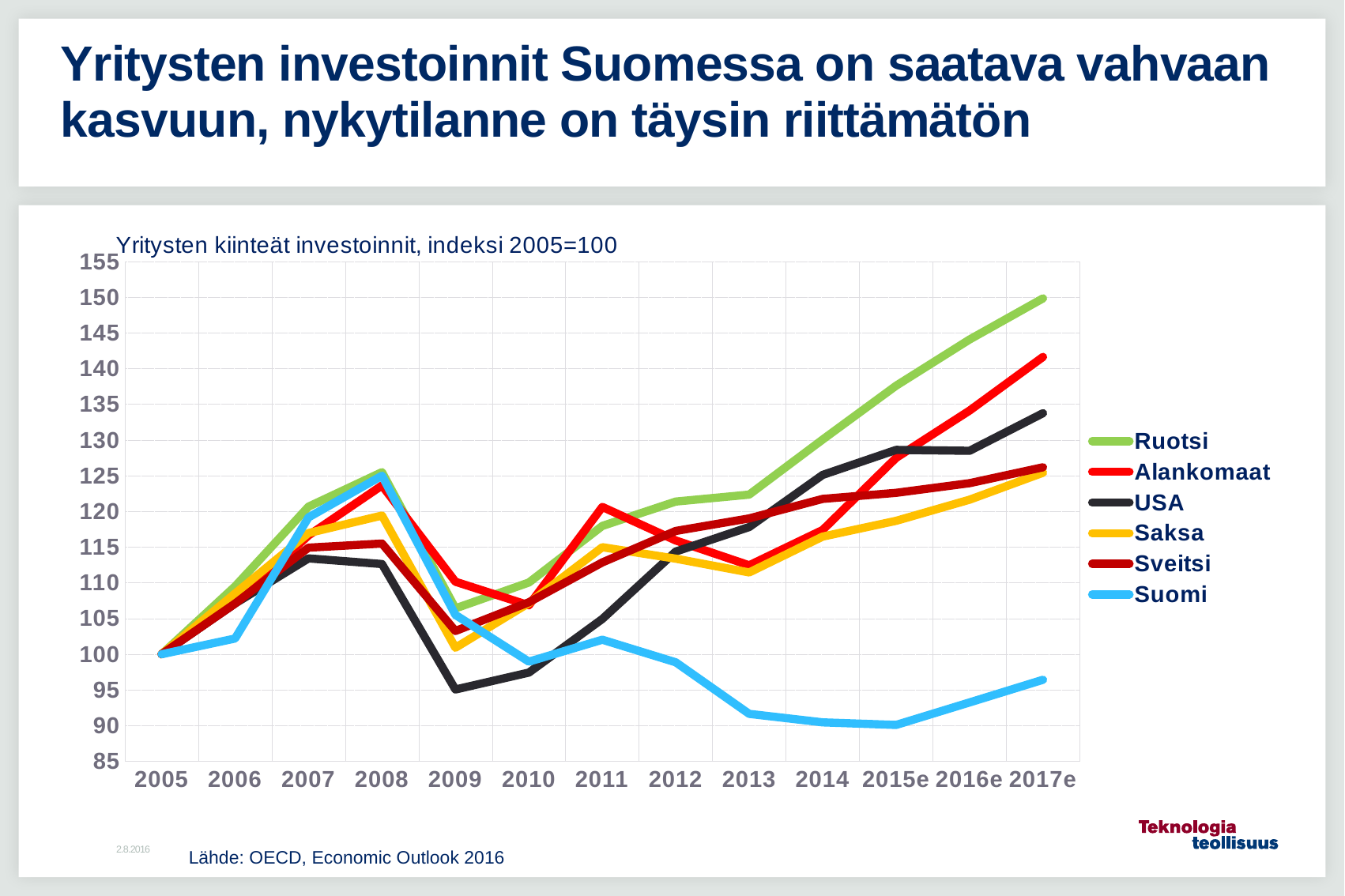
Is the value for USA in 2009 greater or less than 100? less Which country has the lowest index value in 2017e? Suomi How many years are shown on the x axis? 13 Is the value for Ruotsi in 2017e greater or less than 145? greater Is the value for Suomi in 2015e greater or less than 95? less What kind of chart is shown on the slide? line chart Which country has the lowest index value in 2009? USA What is the index value for Suomi in 2005? 100 Which country has the highest index value in 2017e? Ruotsi How many series does the legend list? 6 In 2017e, which is larger: the value for Alankomaat or the value for USA? Alankomaat Does the Suomi line rise or fall from 2011 to 2015e? fall